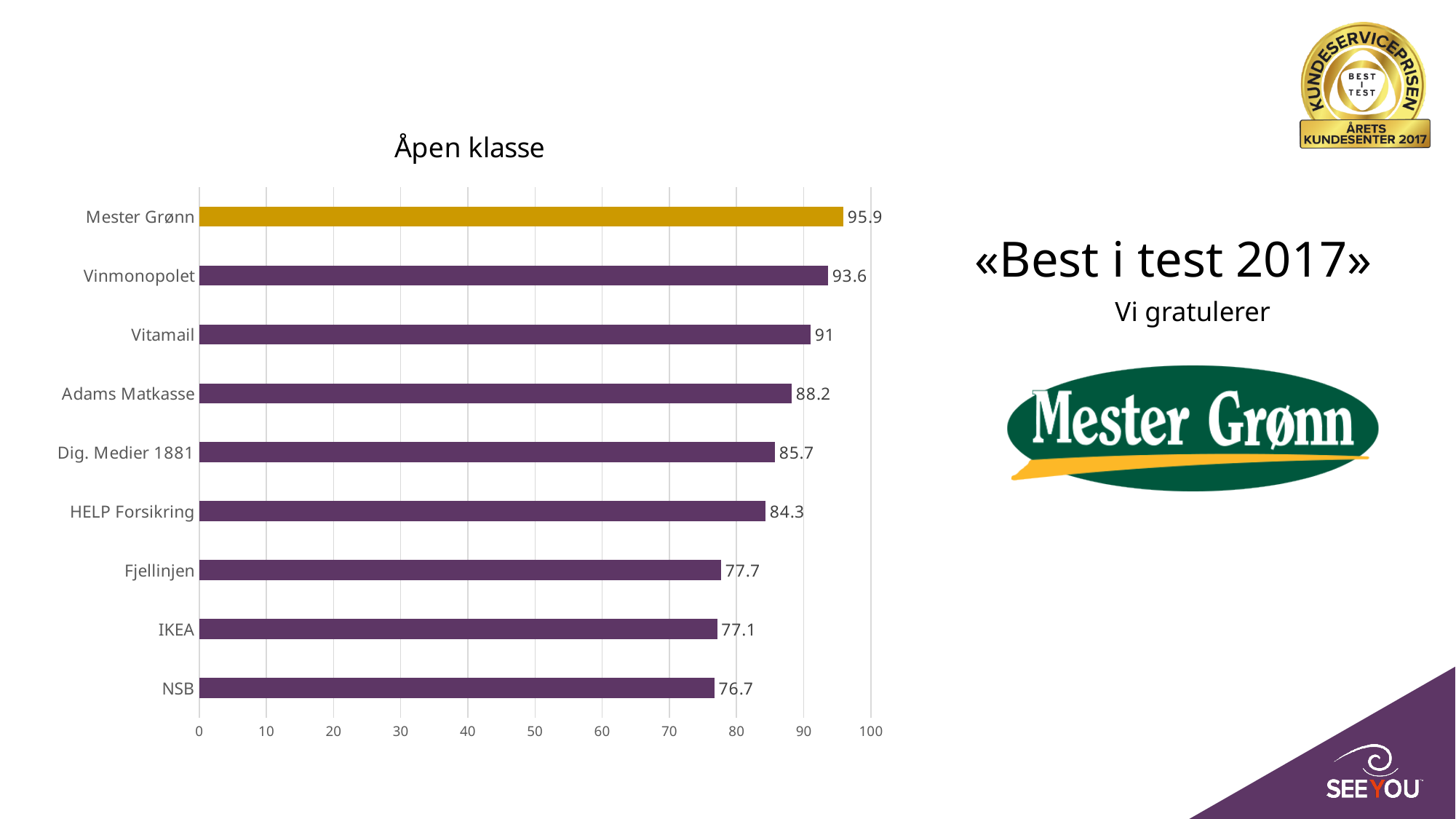
What is the value for Mester Grønn? 95.9 Which category has the lowest value? NSB Which category has the highest value? Mester Grønn Is the value for IKEA greater or less than 80? less What is the difference between the values for Vitamail and HELP Forsikring? 6.7 What is the difference between the values for Mester Grønn and Vinmonopolet? 2.3 What is the title of the chart? Åpen klasse Which has a larger value, Dig. Medier 1881 or Fjellinjen? Dig. Medier 1881 What kind of chart is shown on the slide? bar chart What is the value for Adams Matkasse? 88.2 How many categories are shown in the chart? 9 What is the value for NSB? 76.7